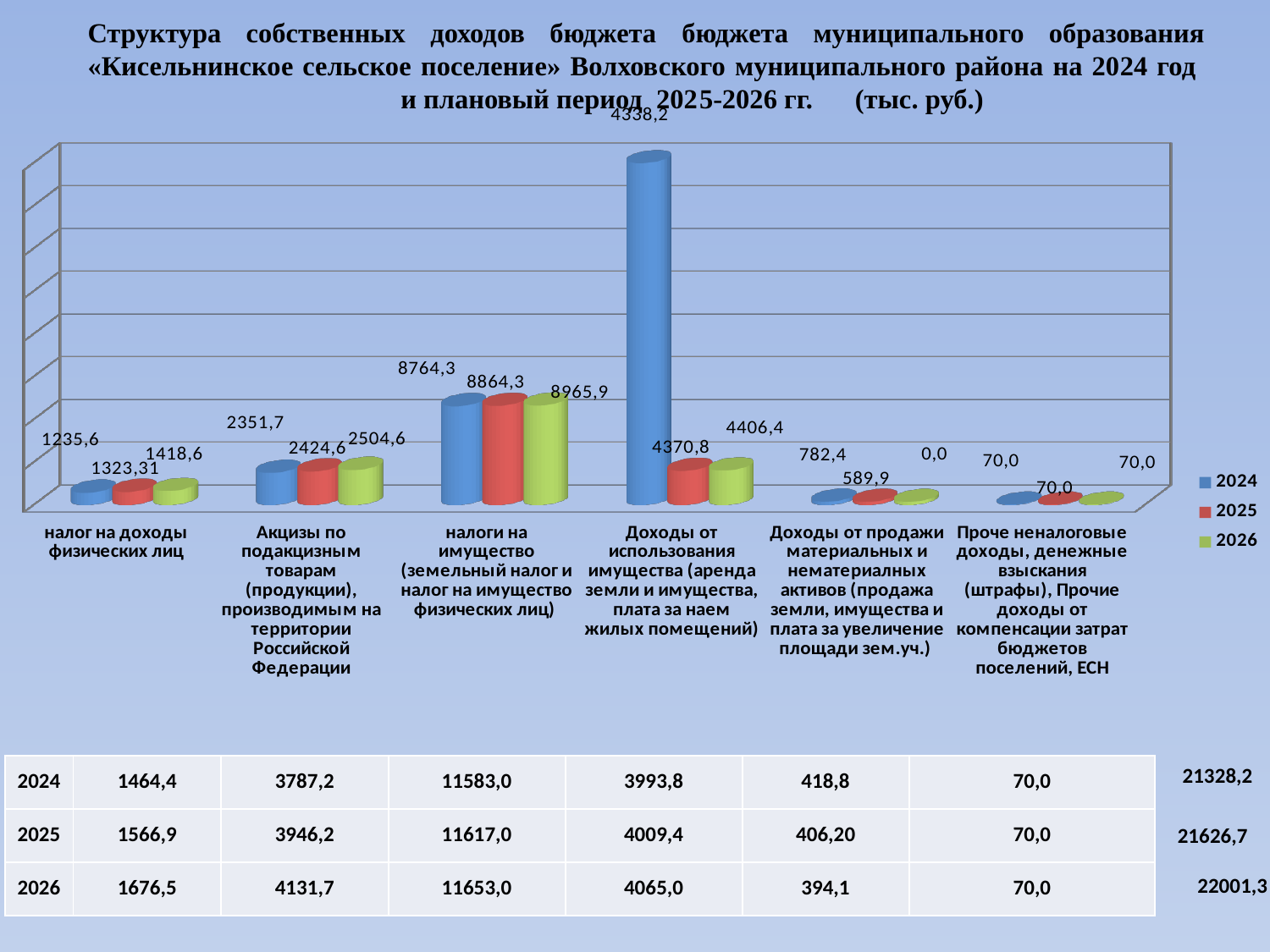
How many series does the legend list? 3 What kind of chart is shown on the slide? bar chart How many categories are shown on the x axis? 6 Which is larger for Доходы от продажи материальных и нематериальных активов: the 2024 value or the 2025 value? 2024 What is the 2025 value for Прочие неналоговые доходы? 70,0 Do the values for Акцизы по подакцизным товарам rise or fall from 2024 to 2026? rise